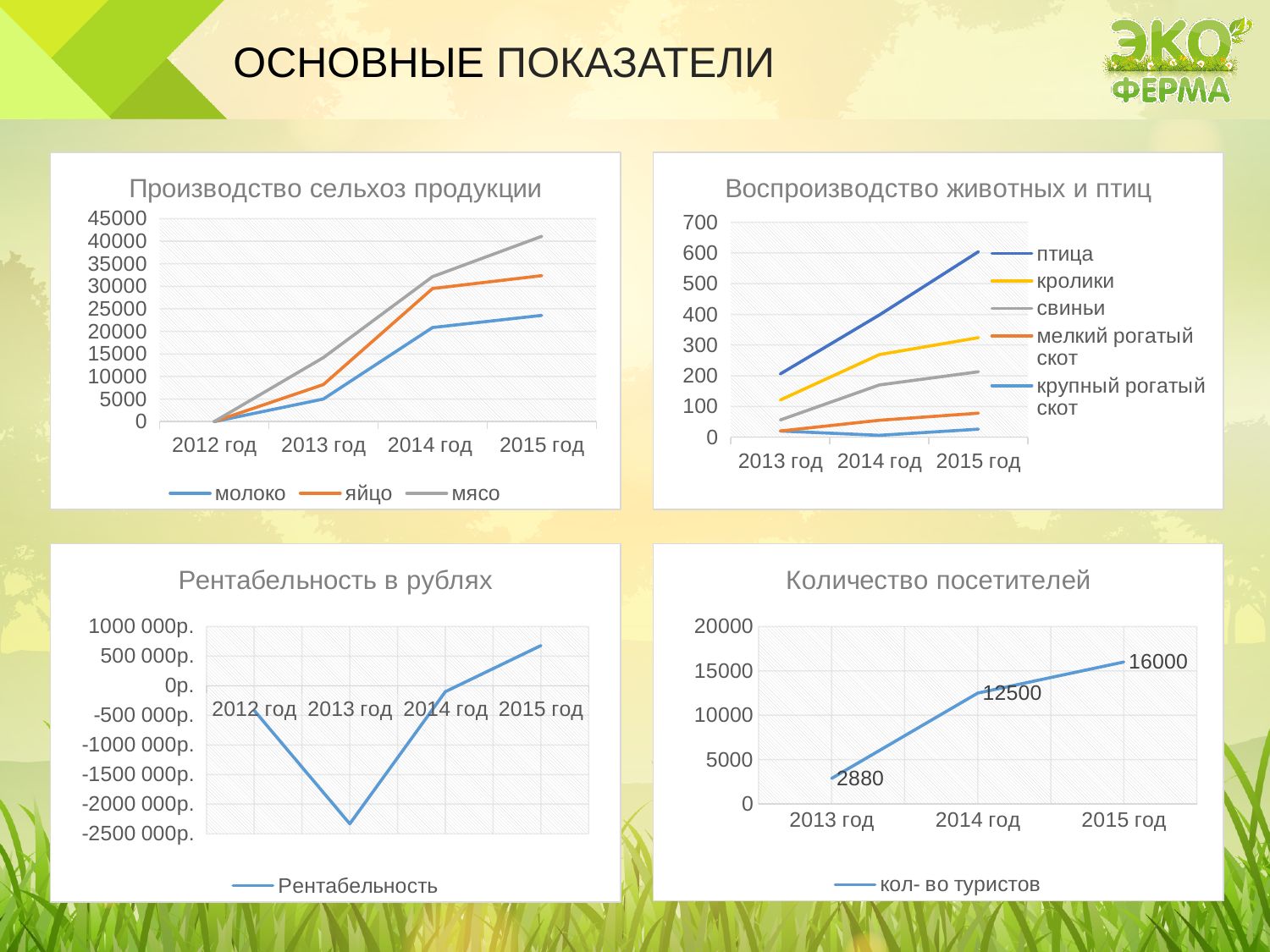
What kind of chart is 'Производство сельхоз продукции'? line chart In the chart 'Производство сельхоз продукции', is the value for мясо in 2015 год greater or less than 35000? greater In the chart 'Количество посетителей', what is the value for 2015 год? 16000 In the chart 'Производство сельхоз продукции', which series has the highest value in 2015 год? мясо In the chart 'Воспроизводство животных и птиц', how many series does the legend list? 5 In the chart 'Количество посетителей', what is the value for 2013 год? 2880 In the chart 'Воспроизводство животных и птиц', which series has the highest value in 2015 год? птица In the chart 'Производство сельхоз продукции', how many series does the legend list? 3 In the chart 'Количество посетителей', what is the difference between the values for 2015 год and 2014 год? 3500 In the chart 'Рентабельность в рублях', which year has the lowest value? 2013 год In the chart 'Количество посетителей', how many years are plotted on the x axis? 3 In the chart 'Количество посетителей', do the values rise or fall from 2013 год to 2015 год? rise